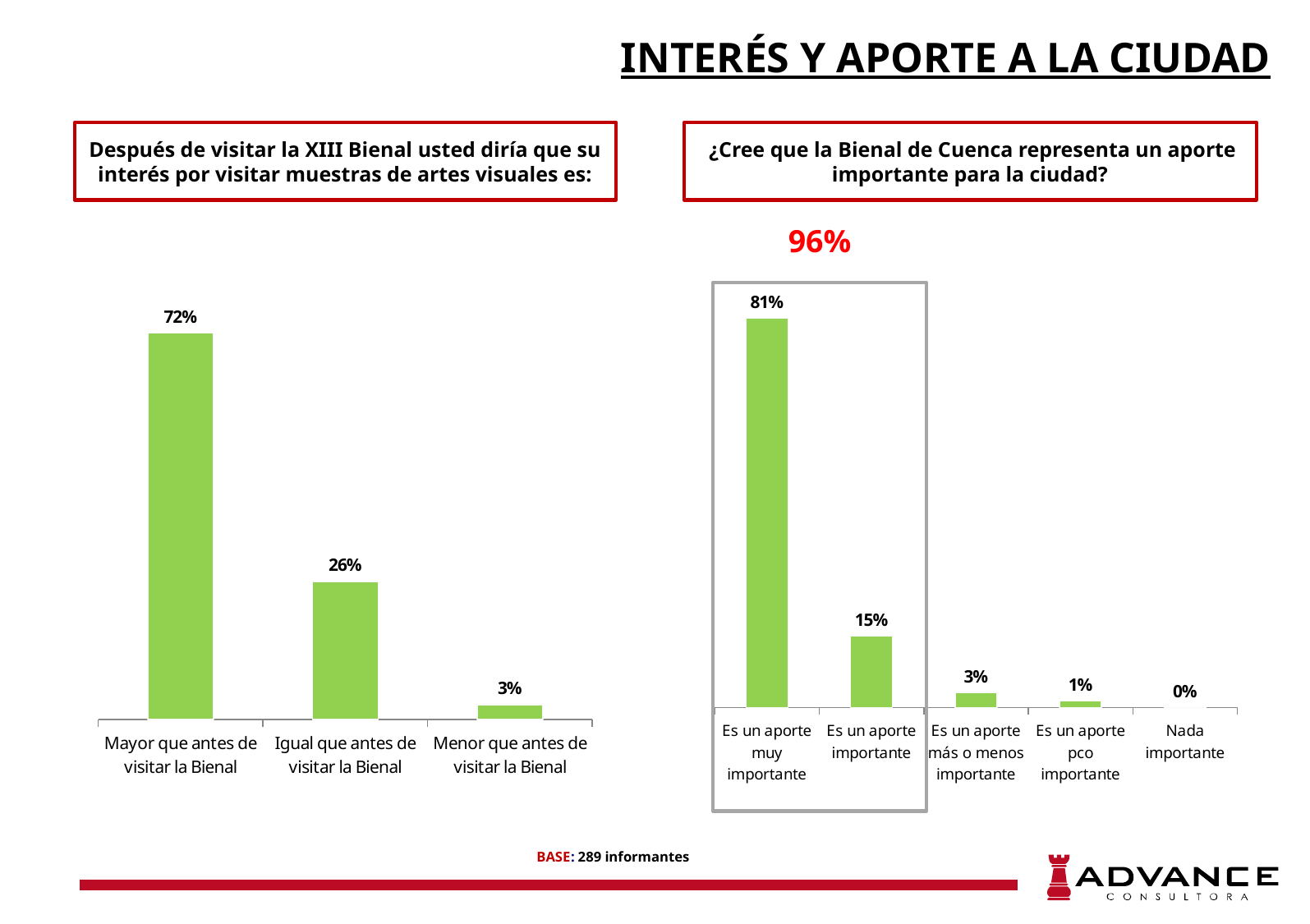
In the left chart, what percentage answered 'Igual que antes de visitar la Bienal'? 26% What type of chart is used on the left side of the slide? Bar chart In the left chart (interest in visiting visual arts exhibitions), what percentage answered 'Mayor que antes de visitar la Bienal'? 72% In the right chart, which category has the highest value? Es un aporte muy importante How many categories does the right chart show? 5 In the right chart, which is larger: 'Es un aporte más o menos importante' or 'Es un aporte pco importante'? Es un aporte más o menos importante In the left chart, which category has the lowest value? Menor que antes de visitar la Bienal In the left chart, what is the difference between 'Mayor que antes de visitar la Bienal' and 'Igual que antes de visitar la Bienal'? 46% In the right chart, what is the combined total of 'Es un aporte muy importante' and 'Es un aporte importante' highlighted above the box? 96% In the right chart (aporte importante para la ciudad), what percentage answered 'Es un aporte muy importante'? 81% How many categories does the left chart show? 3 In the right chart, what percentage answered 'Es un aporte importante'? 15%